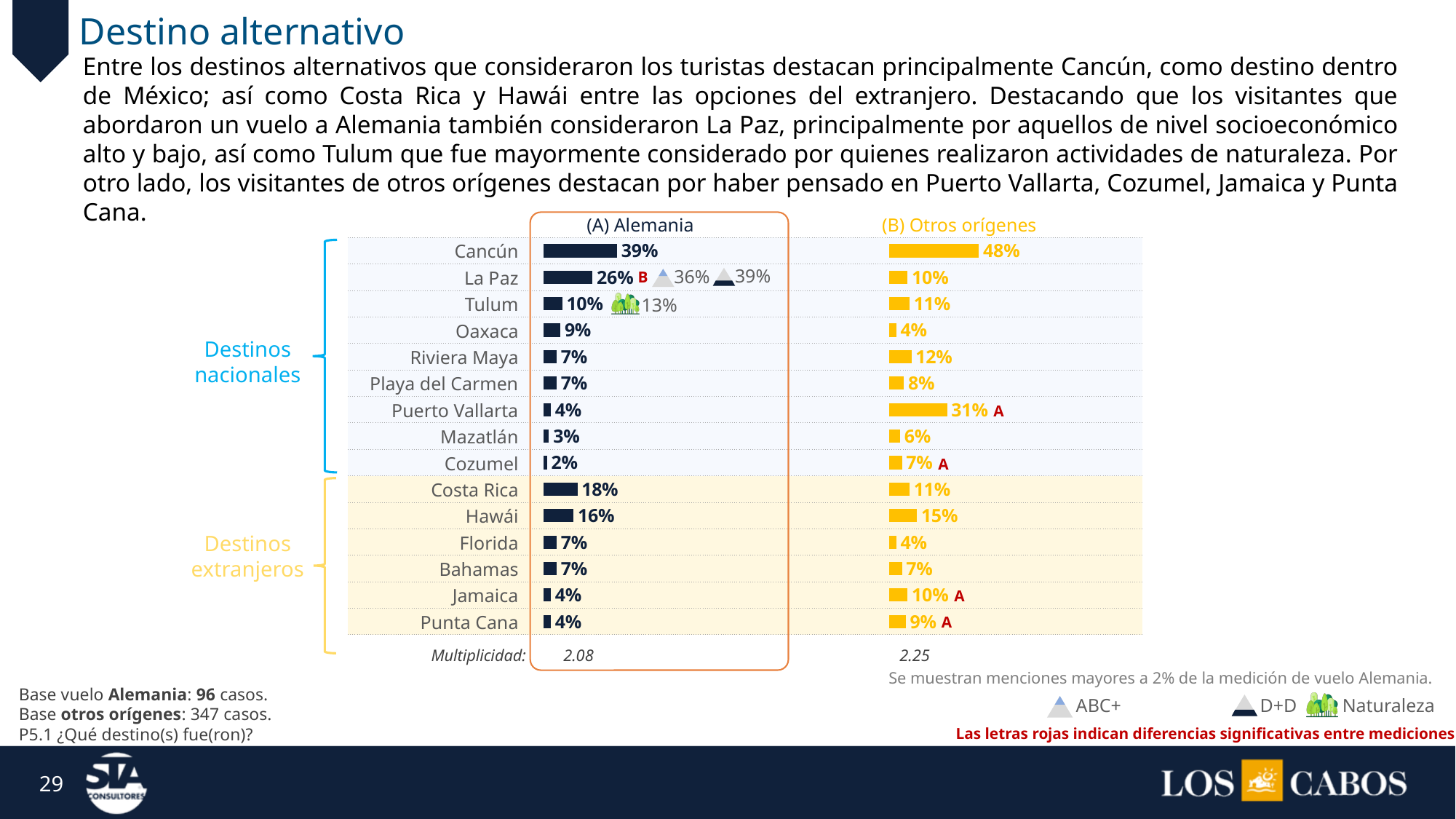
In the (A) Alemania chart, which destination has the lowest value? Cozumel What colour are the bars in the (B) Otros orígenes chart? Yellow What type of chart is used to show the destination values? Bar chart In the (A) Alemania chart, what is the value for Cancún? 39% How many destinations are listed in the charts? 15 In the (B) Otros orígenes chart, what is the value for Puerto Vallarta? 31% In the (B) Otros orígenes chart, which destination has the highest value? Cancún In the (A) Alemania chart, what is the difference between Costa Rica and Hawái? 2 percentage points In the (A) Alemania chart, what is the value for Costa Rica? 18% What is the Multiplicidad value shown for the (B) Otros orígenes chart? 2.25 Which is larger: the La Paz value in the (A) Alemania chart or in the (B) Otros orígenes chart? (A) Alemania What is the difference between the Cancún values in the (B) Otros orígenes chart and the (A) Alemania chart? 9 percentage points